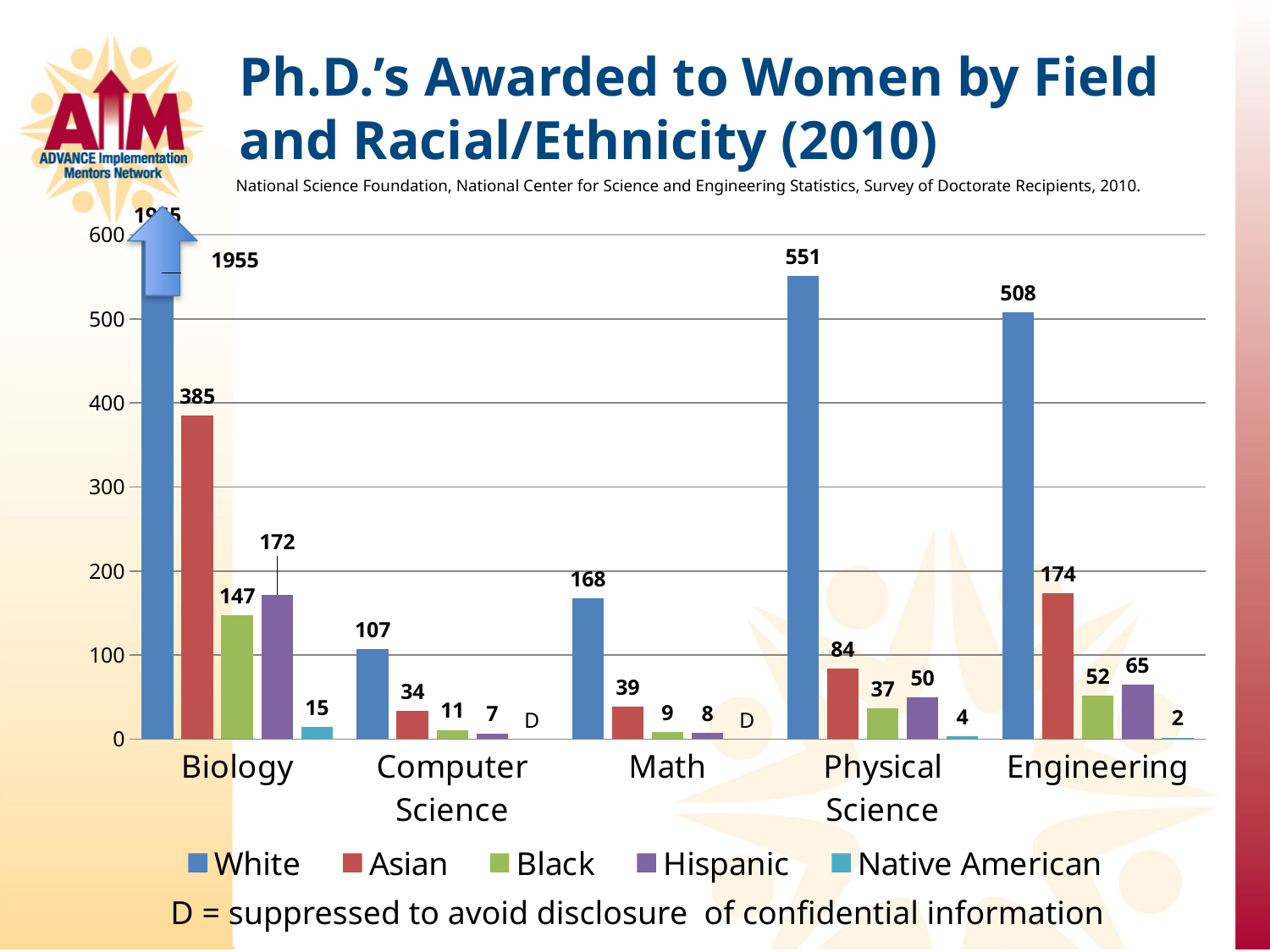
According to the note below the legend, what does D stand for? Suppressed to avoid disclosure of confidential information How many fields are shown on the x axis? 5 Which field has the highest value for White? Biology What is the value for White in Physical Science? 551 Which field has the lowest value for Black? Math Which is larger, the Hispanic value in Biology or the Black value in Biology? Hispanic value in Biology What kind of chart is shown on the slide? Bar chart What is the value for Hispanic in Engineering? 65 What is the value for Native American in Computer Science? D How many series does the legend list? 5 What is the difference between the White values for Physical Science and Engineering? 43 What is the value for Asian in Biology? 385